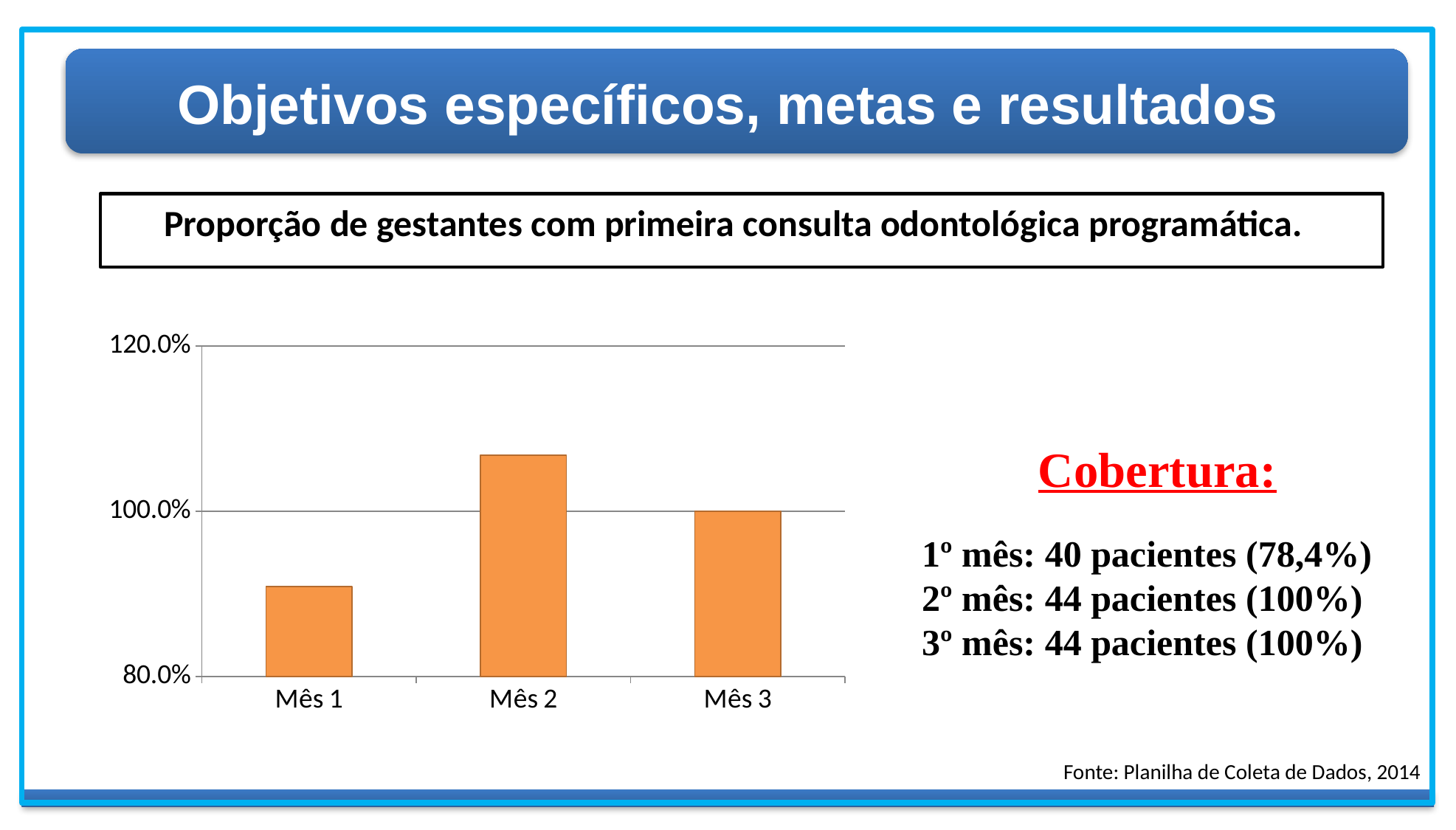
What kind of chart is shown on the slide? bar chart What colour are the bars in the chart? orange Is the value for Mês 2 greater or less than 100.0%? greater What is the title shown above the chart? Proporção de gestantes com primeira consulta odontológica programática. How many categories are plotted on the x axis of the chart? 3 Which month has the highest bar in the chart? Mês 2 What value does the bar for Mês 3 reach on the y axis? 100.0% Does the value rise or fall from Mês 1 to Mês 2? rise Which month has the lowest bar in the chart? Mês 1 Which is larger, the bar for Mês 2 or the bar for Mês 3? Mês 2 Is the value for Mês 1 greater or less than 100.0%? less Which is larger, the bar for Mês 1 or the bar for Mês 2? Mês 2